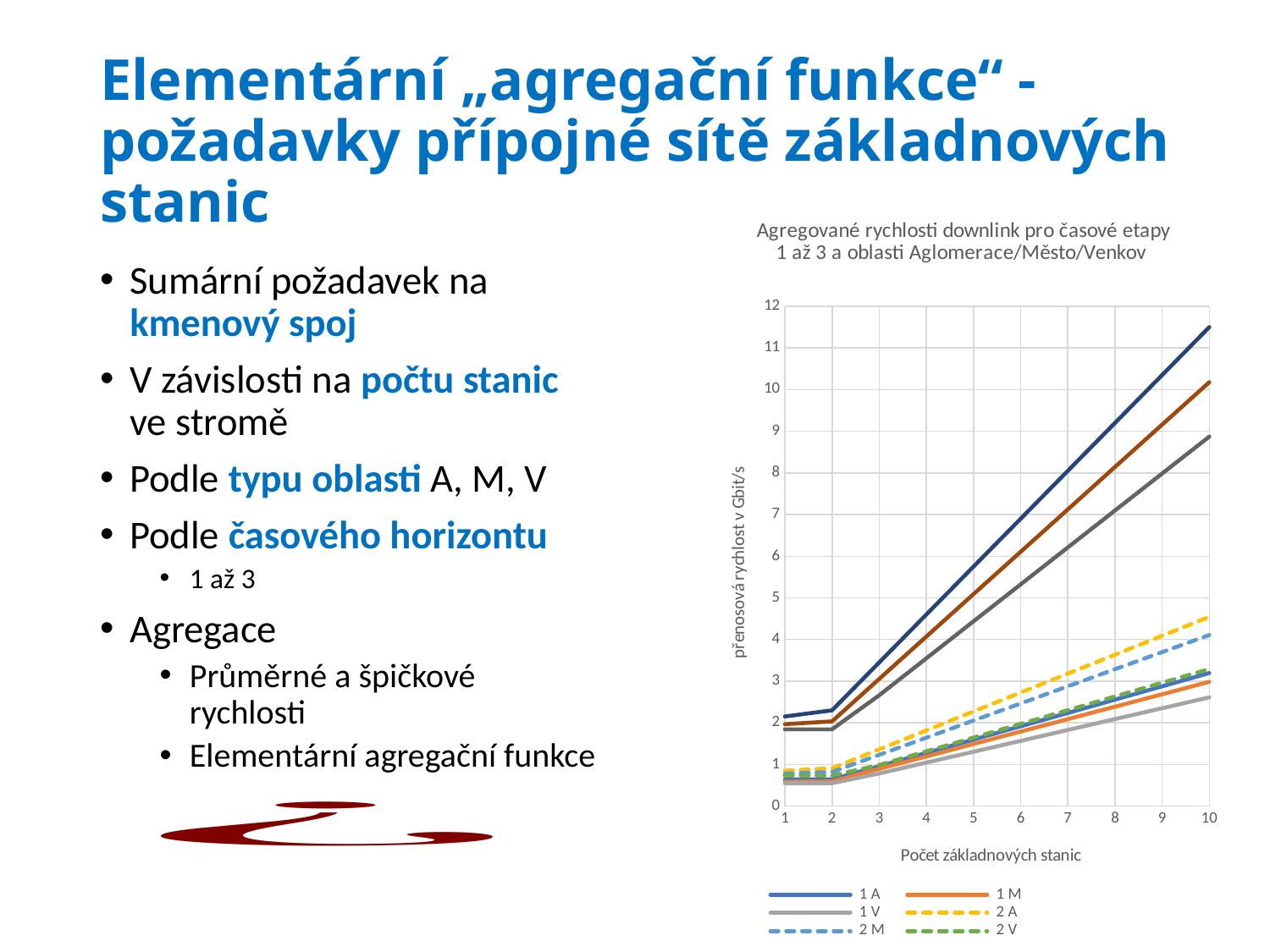
How many values are shown on the x axis of the chart? 10 Is the value for series 1 V at 10 base stations greater or less than 3? less What is the title of the chart? Agregované rychlosti downlink pro časové etapy 1 až 3 a oblasti Aglomerace/Město/Venkov What is the label of the x axis of the chart? Počet základnových stanic Do the values of the series 1 A rise or fall as the number of base stations increases? rise How many series does the chart legend list? 6 Among the series listed in the legend, which has the highest value at 10 base stations? 2 A Which of the legend series, 1 A or 1 V, has the higher value at 10 base stations? 1 A Which of the legend series, 2 A or 1 V, has the higher value at 10 base stations? 2 A Is the value for series 2 A at 10 base stations greater or less than 4? greater Is the value for series 1 A at 1 base station greater or less than 1? less What kind of chart is shown on the slide? line chart